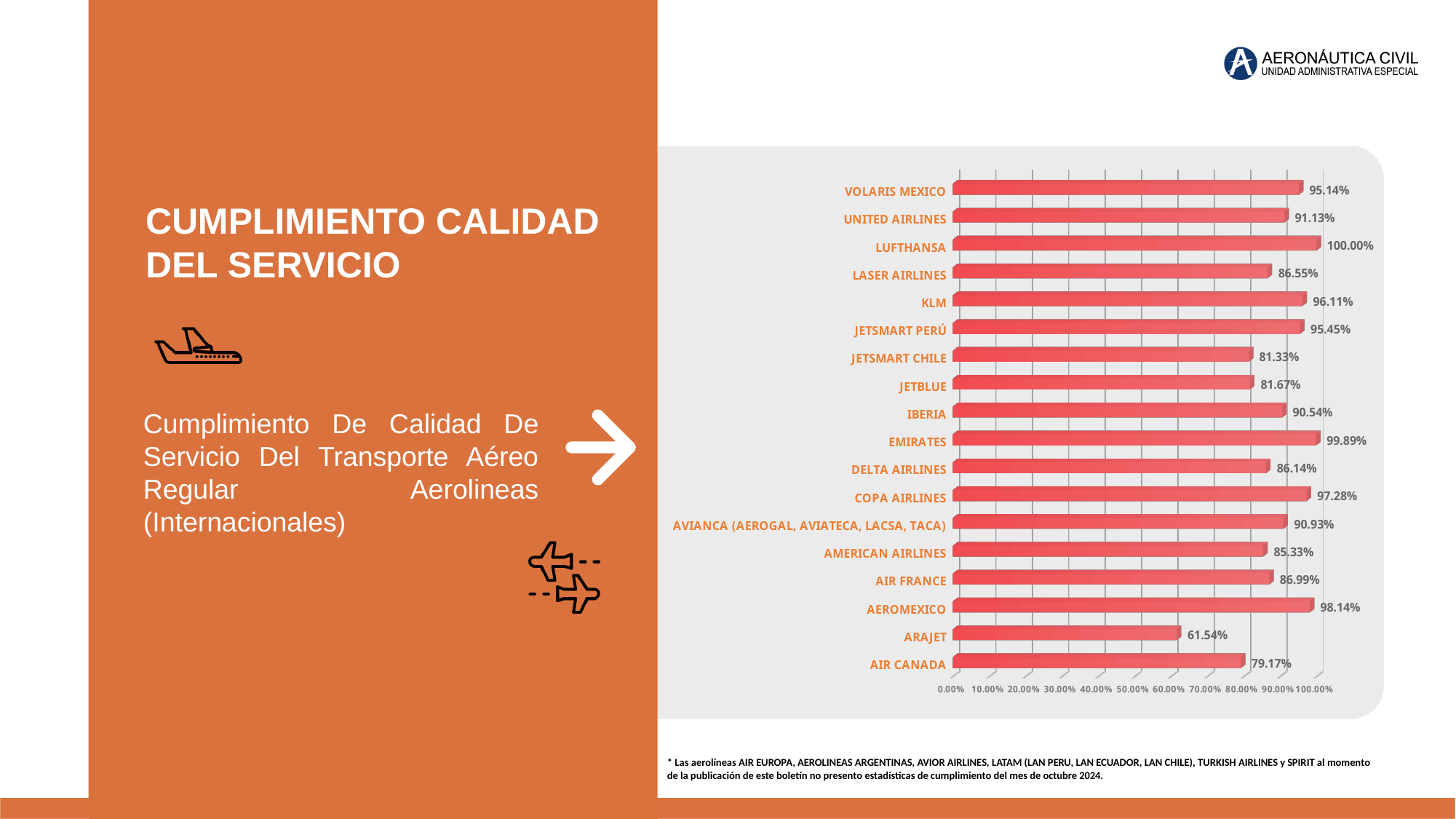
What is the difference between the values for KLM and JETBLUE? 14.44% Which airline has the lowest value? ARAJET What is the value for COPA AIRLINES? 97.28% What is the value for ARAJET? 61.54% Which airline has the highest value? LUFTHANSA What is the difference between the values for LUFTHANSA and ARAJET? 38.46% What is the value for AIR CANADA? 79.17% What kind of chart is shown on the slide? bar chart Is the value for JETSMART CHILE greater or less than 90.00%? less What is the value for LUFTHANSA? 100.00% How many airlines are shown in the chart? 18 Which has a larger value, EMIRATES or DELTA AIRLINES? EMIRATES